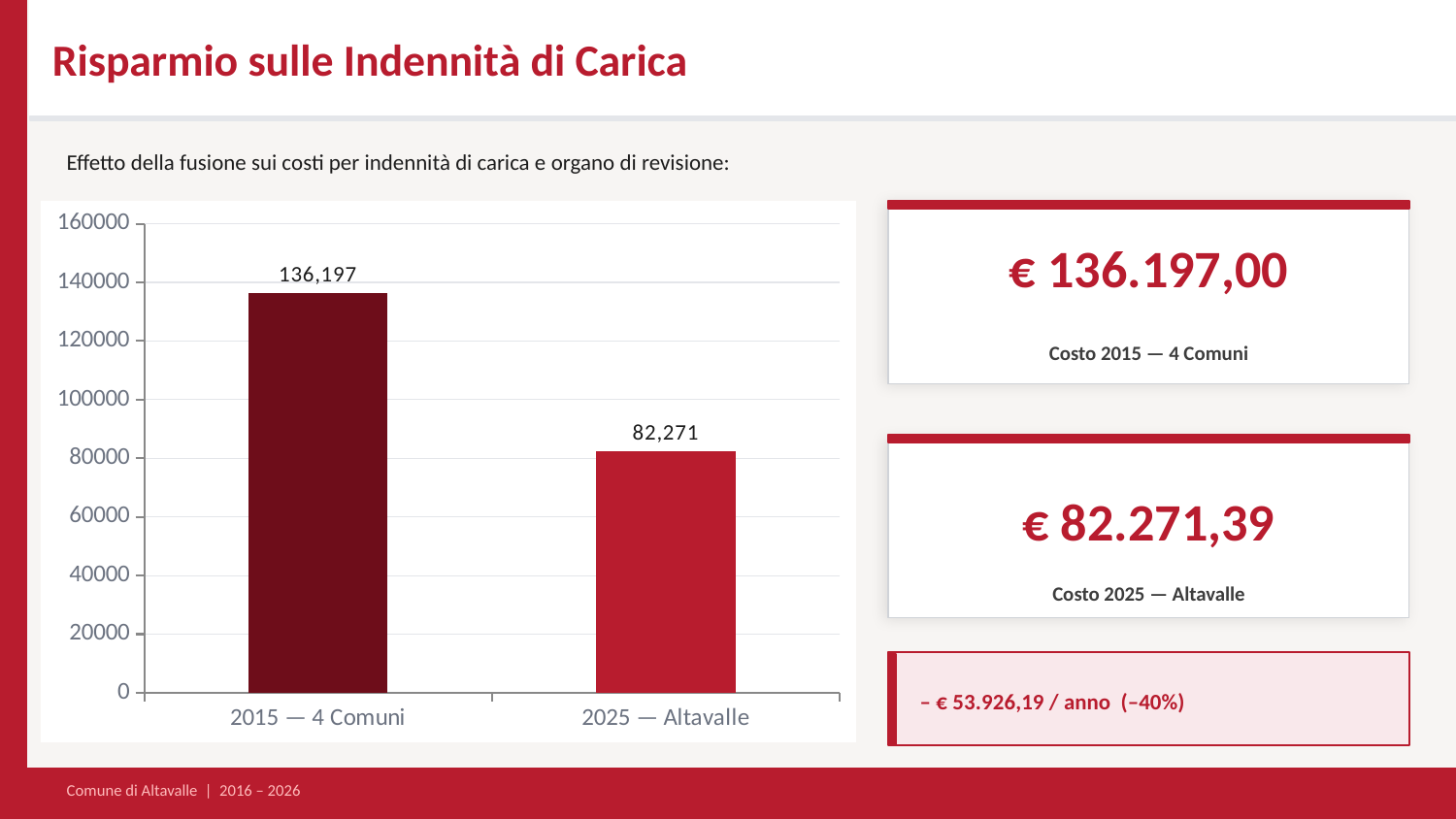
What is the value shown for the 2015 — 4 Comuni bar? 136,197 How many categories are plotted on the x axis of the chart? 2 Is the value for 2025 — Altavalle greater or less than 100000? less Which category has the lowest value in the chart? 2025 — Altavalle What is the maximum value shown on the chart's vertical axis? 160000 Do the values rise or fall from 2015 — 4 Comuni to 2025 — Altavalle? fall Which category has the highest value in the chart? 2015 — 4 Comuni What is the value shown for the 2025 — Altavalle bar? 82,271 Which is larger, the value for 2015 — 4 Comuni or the value for 2025 — Altavalle? 2015 — 4 Comuni What kind of chart is shown on the slide? bar chart Is the value for 2015 — 4 Comuni greater or less than 120000? greater What is the difference between the 2015 — 4 Comuni value and the 2025 — Altavalle value? 53,926